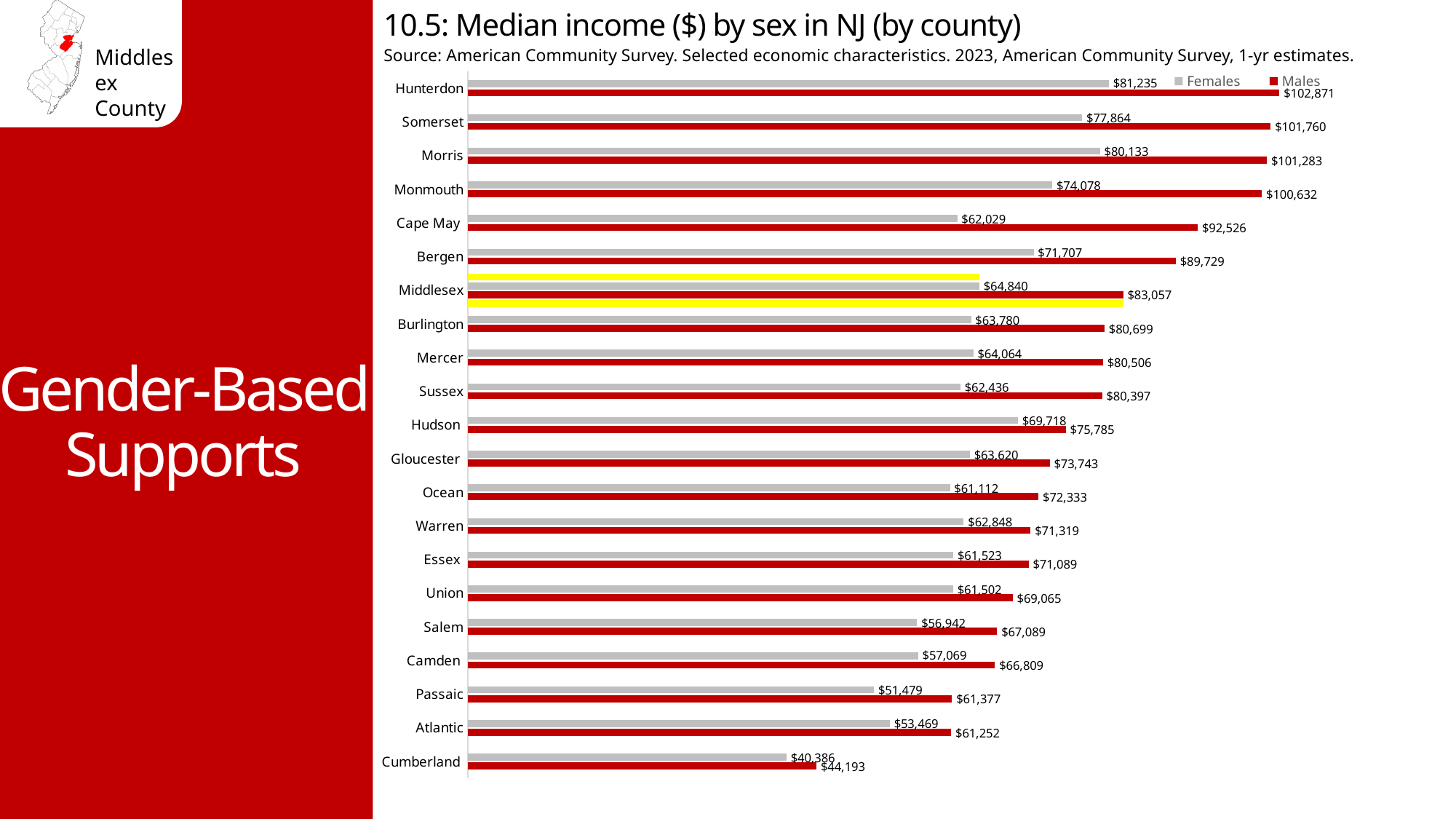
What is the median income for females in Hunterdon County? $81,235 What is the difference between male and female median income in Cumberland County? $3,807 Which county has the lowest median income for females? Cumberland Which is larger: the female median income in Hudson County or in Bergen County? Bergen County Which county has the highest median income for males? Hunterdon What is the median income for females in Cumberland County? $40,386 How many counties are shown in the chart? 21 How many series does the legend list? 2 What is the median income for males in Middlesex County? $83,057 Which county's bars are highlighted in yellow on the chart? Middlesex What kind of chart is shown on the slide? Bar chart What is the difference between male and female median income in Middlesex County? $18,217